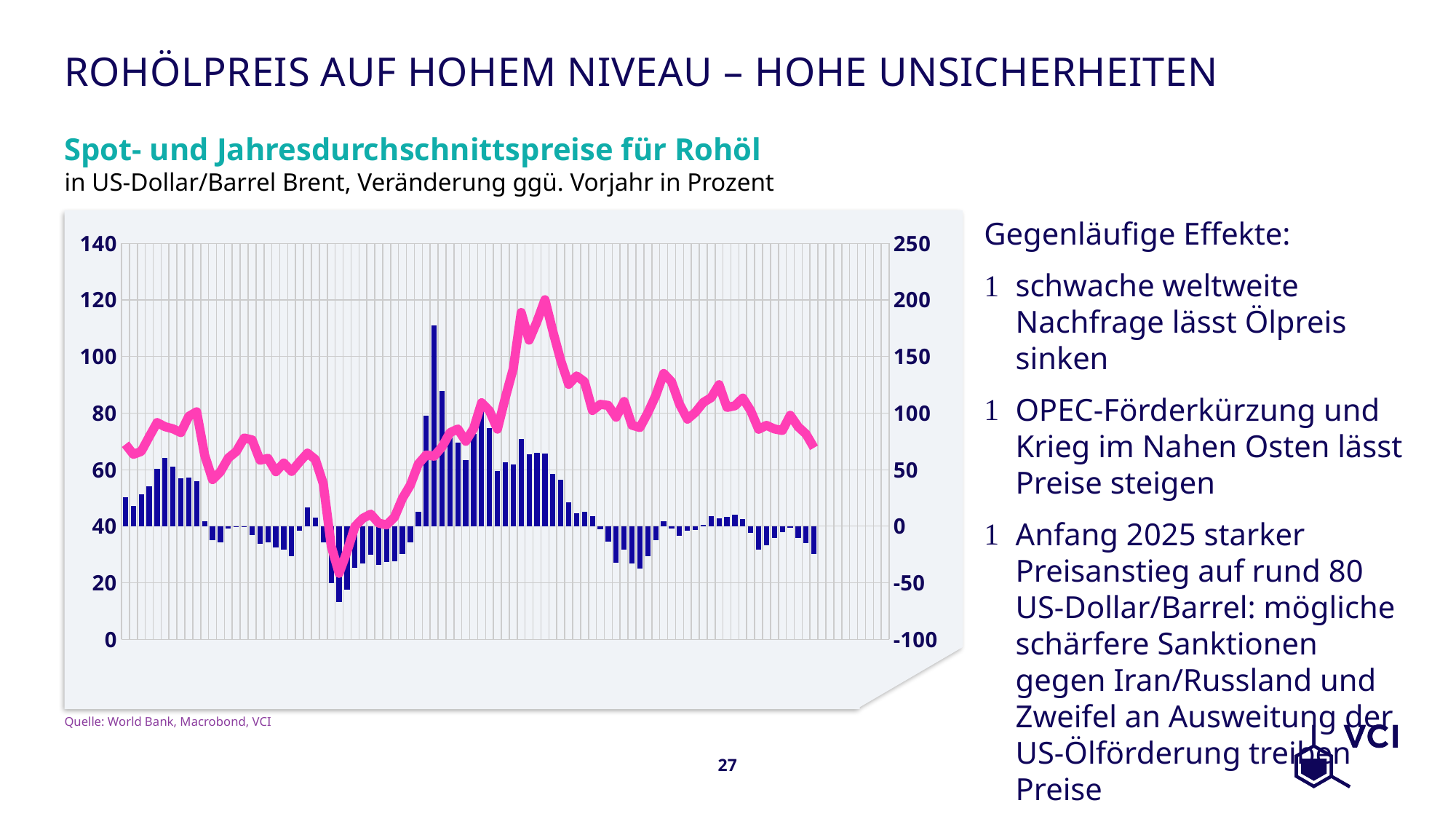
What is the highest tick value on the left vertical axis of the chart? 140 How many data series are plotted in the chart? 2 What is the title of the chart? Spot- und Jahresdurchschnittspreise für Rohöl Is the peak value of the pink line greater or less than 100 on the left axis? greater Does the pink line rise or fall over the last few points at the right end of the chart? fall Is the tallest blue bar greater or less than 150 on the right axis? greater What source is cited below the chart? World Bank, Macrobond, VCI Is the lowest value of the pink line greater or less than 40 on the left axis? less What kind of chart is shown on the slide? A combined bar and line chart What is the highest tick value on the right vertical axis of the chart? 250 What is the lowest tick value on the right vertical axis of the chart? -100